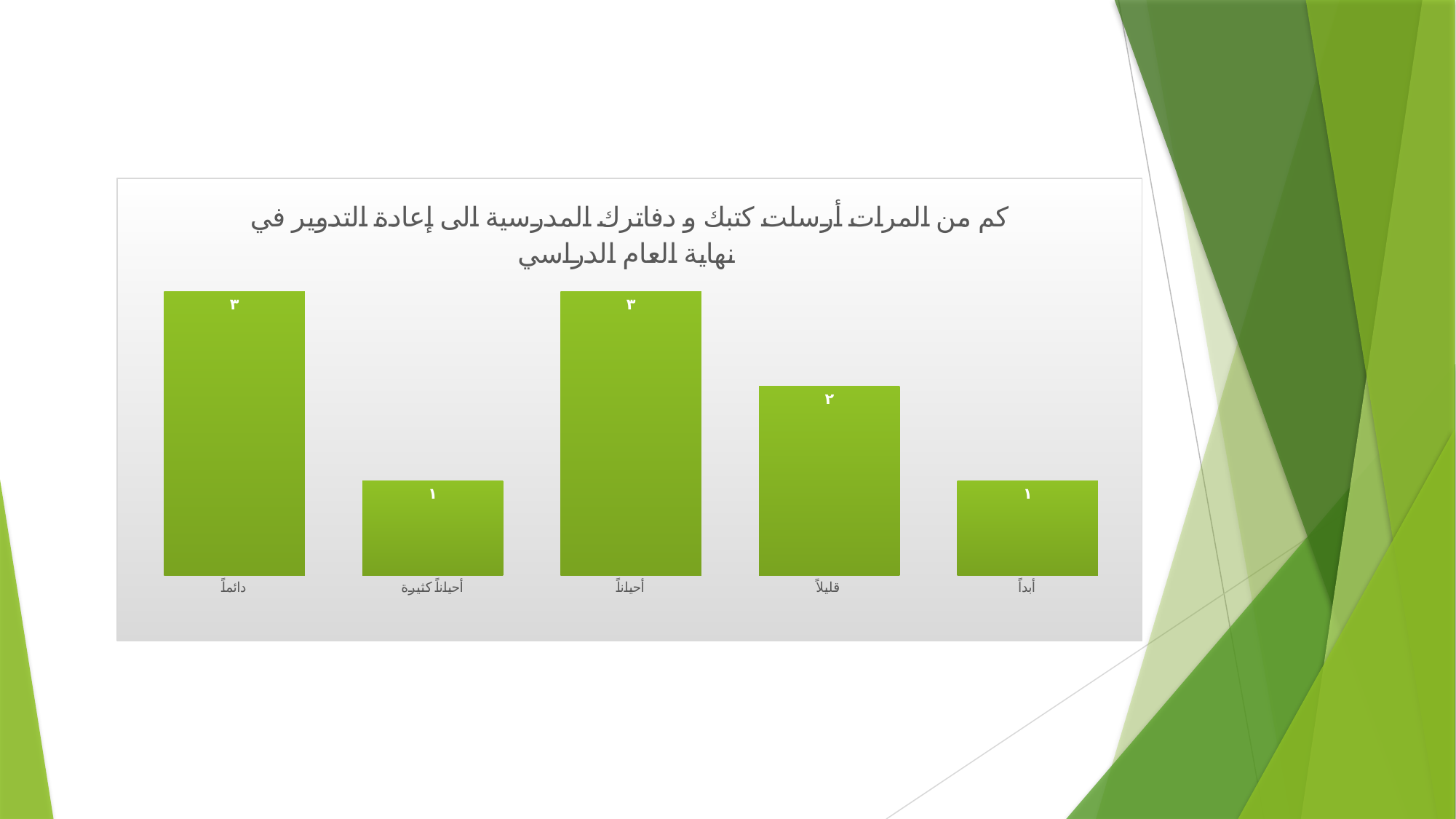
What kind of chart is shown on the slide? Bar chart What is the difference between the value for دائماً and the value for قليلاً? ١ What is the difference between the value for أحياناً and the value for أبداً? ٢ What colour are the bars in the chart? Green What value is shown for the category أحياناً كثيرة? ١ What value is shown for the category أبداً? ١ Which is larger, the value for أحياناً كثيرة or the value for أحياناً? أحياناً What value is shown for the category أحياناً? ٣ What value is shown for the category دائماً? ٣ What value is shown for the category قليلاً? ٢ How many categories are shown in the chart? 5 Which is larger, the value for قليلاً or the value for أبداً? قليلاً